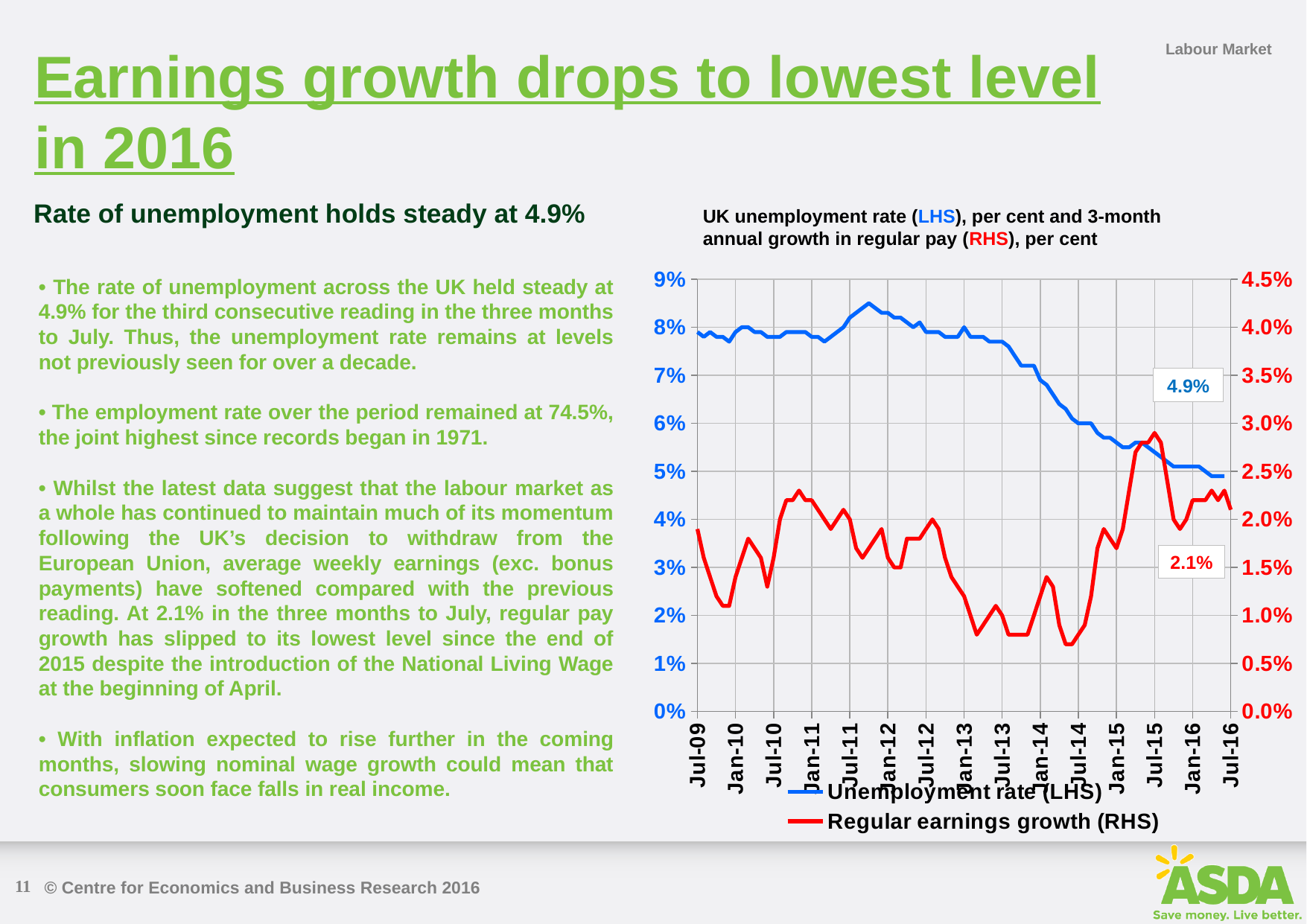
How many series does the chart's legend list? 2 Is regular earnings growth (RHS) at Jul-14 greater or less than 1.0%? less Is the unemployment rate (LHS) at Jul-09 greater or less than 7%? greater What colour is the line for regular earnings growth (RHS)? red Is the unemployment rate (LHS) at Jul-16 greater or less than 6%? less Does the unemployment rate (LHS) rise or fall overall between Jul-09 and Jul-16? fall What is the latest labelled value of the unemployment rate (LHS) on the chart? 4.9% What is the title of the chart? UK unemployment rate (LHS), per cent and 3-month annual growth in regular pay (RHS), per cent Is the unemployment rate (LHS) higher at Jul-09 or at Jul-16? Jul-09 What kind of chart is shown on the slide? line chart What is the latest labelled value of regular earnings growth (RHS) on the chart? 2.1%